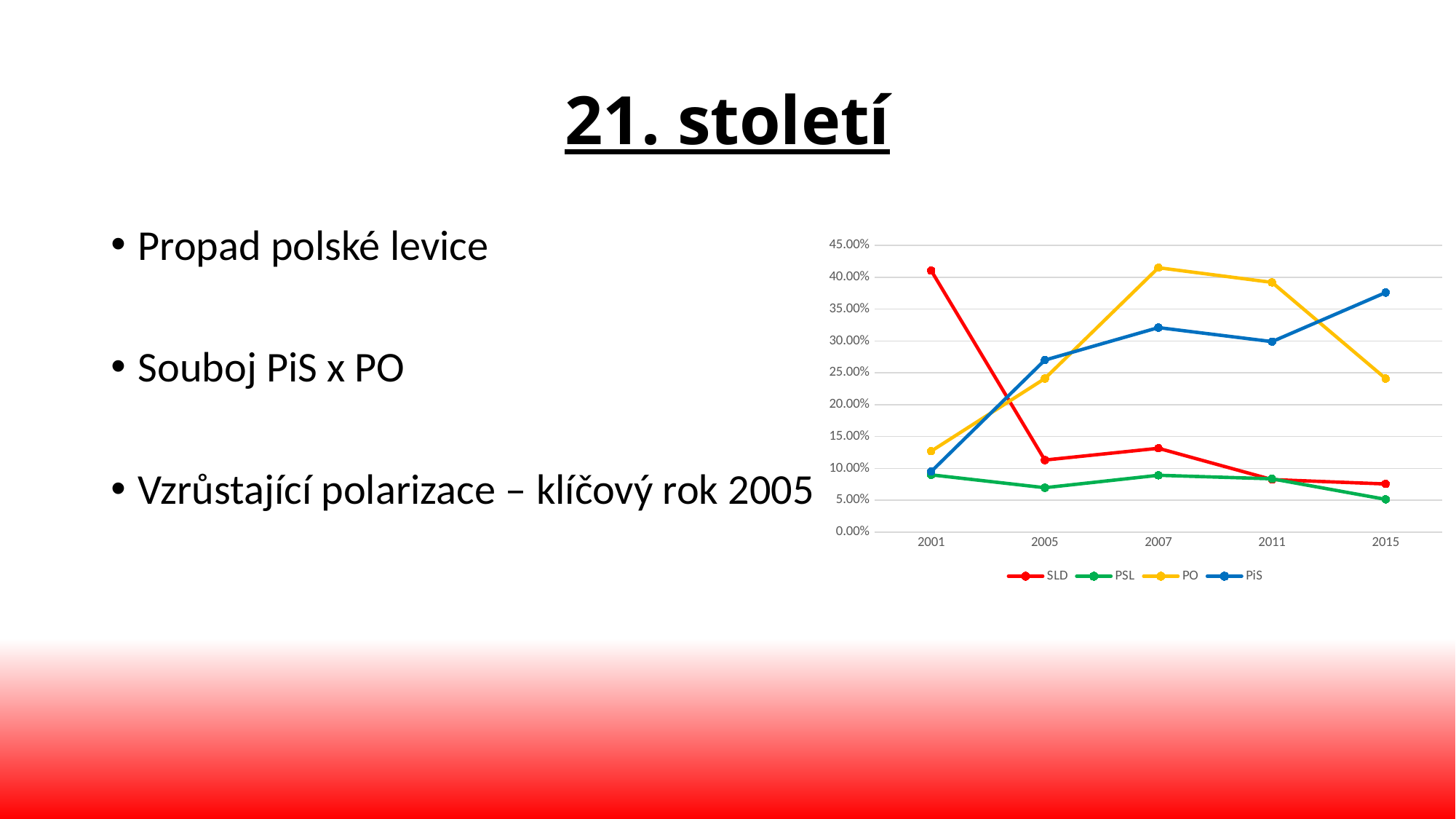
Which series has the highest value in 2001? SLD Which series has the lowest value in 2015? PSL What colour is the line for PO in the chart? yellow Is the value for PiS in 2015 greater or less than 35.00%? greater How many years are plotted along the x axis of the chart? 5 In 2011, which is larger, the value for PO or the value for PiS? PO How many series does the chart's legend list? 4 What kind of chart is shown on the slide? line chart Is the value for SLD in 2001 greater or less than 35.00%? greater Which series has the highest value in 2015? PiS Does the value for SLD rise or fall from 2001 to 2005? fall Is the value for PSL in 2015 greater or less than 10.00%? less